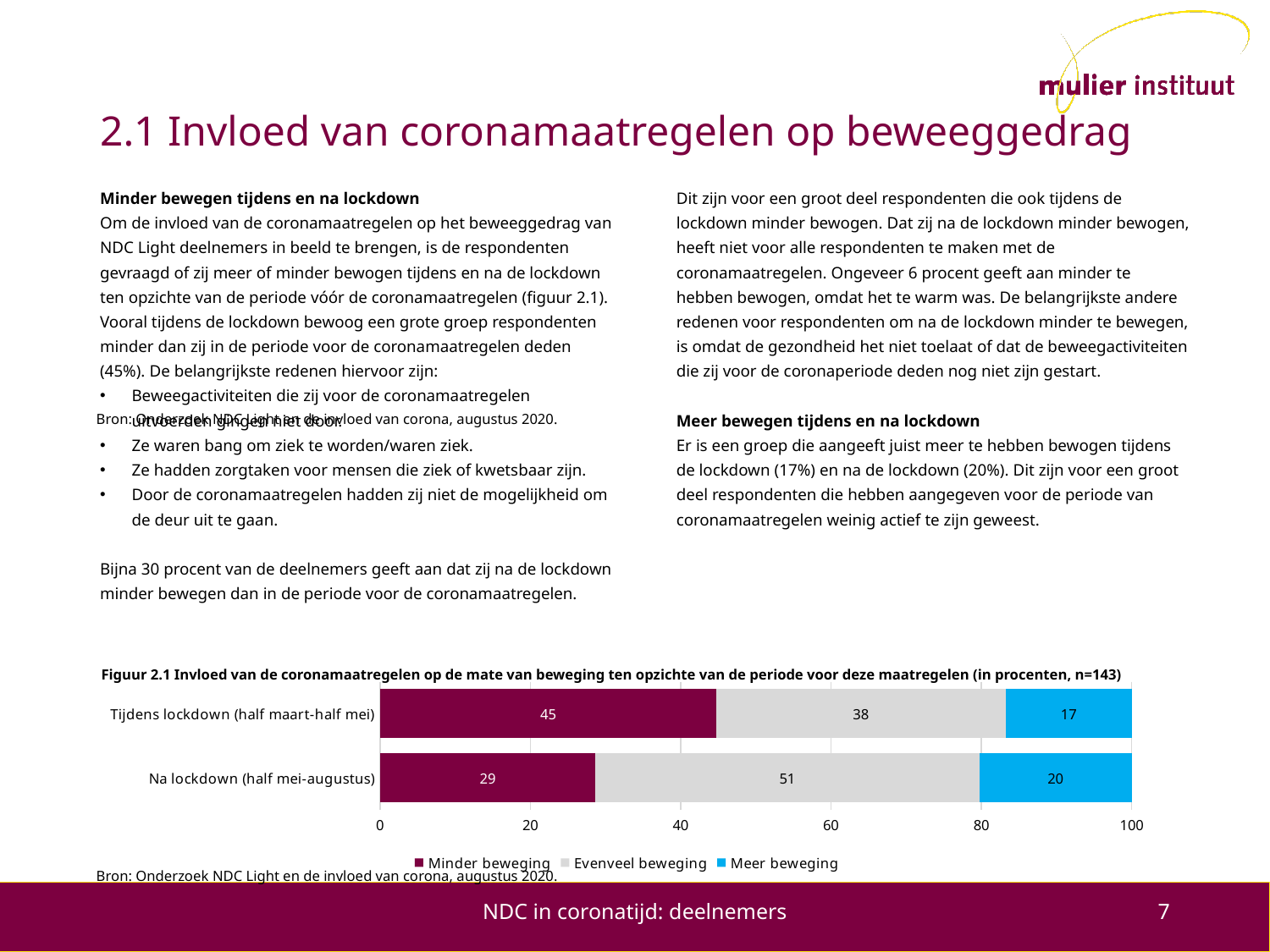
How many categories are shown on the chart? 2 What kind of chart is shown on the slide? Stacked bar chart What is the total of the stacked bar for 'Na lockdown (half mei-augustus)'? 100 Is the 'Minder beweging' value larger for 'Tijdens lockdown (half maart-half mei)' or for 'Na lockdown (half mei-augustus)'? Tijdens lockdown (half maart-half mei) Which category has the lower value for 'Meer beweging'? Tijdens lockdown (half maart-half mei) How many series does the legend list? 3 What is the value for 'Evenveel beweging' in the 'Na lockdown (half mei-augustus)' bar? 51 What is the value for 'Meer beweging' in the 'Tijdens lockdown (half maart-half mei)' bar? 17 What is the value for 'Minder beweging' in the 'Na lockdown (half mei-augustus)' bar? 29 Which category has the higher value for 'Minder beweging'? Tijdens lockdown (half maart-half mei) What is the difference between the 'Evenveel beweging' values for 'Na lockdown (half mei-augustus)' and 'Tijdens lockdown (half maart-half mei)'? 13 What is the value for 'Minder beweging' in the 'Tijdens lockdown (half maart-half mei)' bar? 45